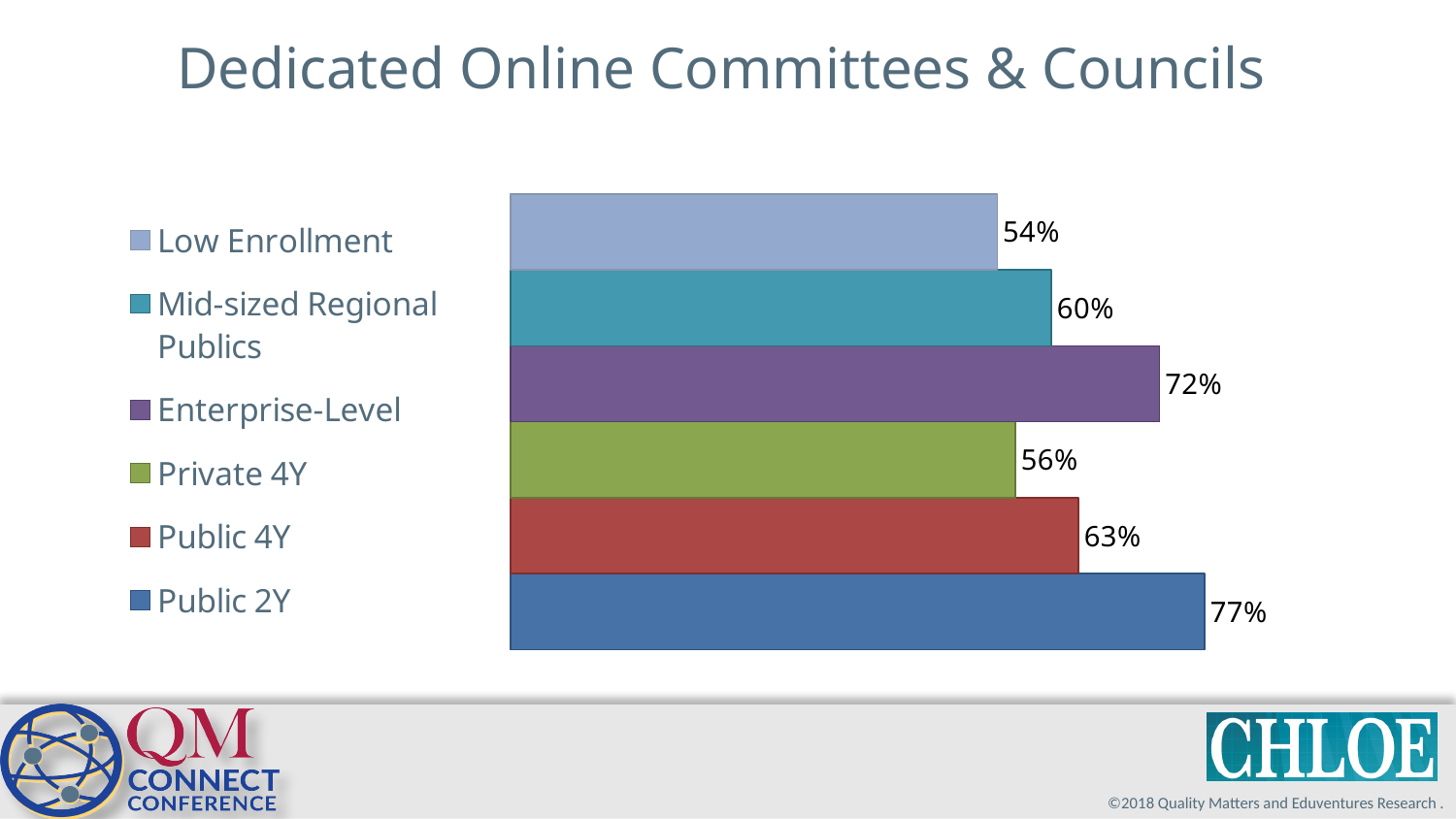
Which group has the highest value? Public 2Y What is the value for Mid-sized Regional Publics? 60% What kind of chart is shown on the slide? Bar chart How many series does the legend list? 6 How many bars are plotted in the chart? 6 Which is larger, the value for Public 4Y or the value for Private 4Y? Public 4Y Which group has the lowest value? Low Enrollment What is the value for Public 2Y? 77% What is the difference between the values for Enterprise-Level and Private 4Y? 16% What is the value for Low Enrollment? 54% What is the value for Enterprise-Level? 72% What is the difference between the values for Public 2Y and Public 4Y? 14%